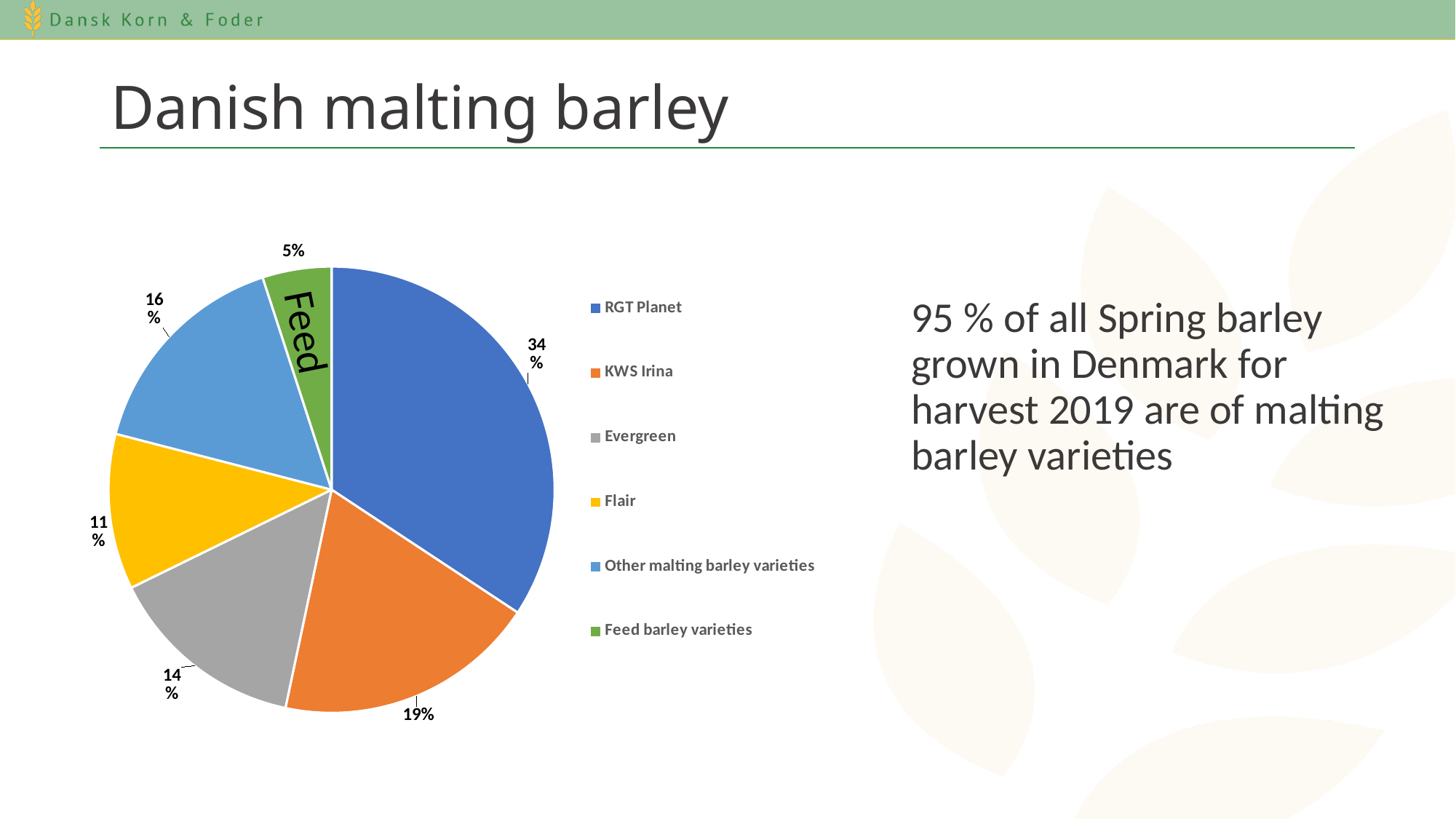
What is the difference in percentage points between RGT Planet and KWS Irina? 15 What share of the pie does RGT Planet have? 34% How many categories does the legend list? 6 Which category has the largest slice of the pie? RGT Planet What share of the pie do Feed barley varieties have? 5% What share of the pie does Evergreen have? 14% What kind of chart is shown on the slide? pie chart What share of the pie does Flair have? 11% What share of the pie do Other malting barley varieties have? 16% Which category has the smallest slice of the pie? Feed barley varieties Which is larger, the slice for Flair or the slice for Other malting barley varieties? Other malting barley varieties What share of the pie does KWS Irina have? 19%